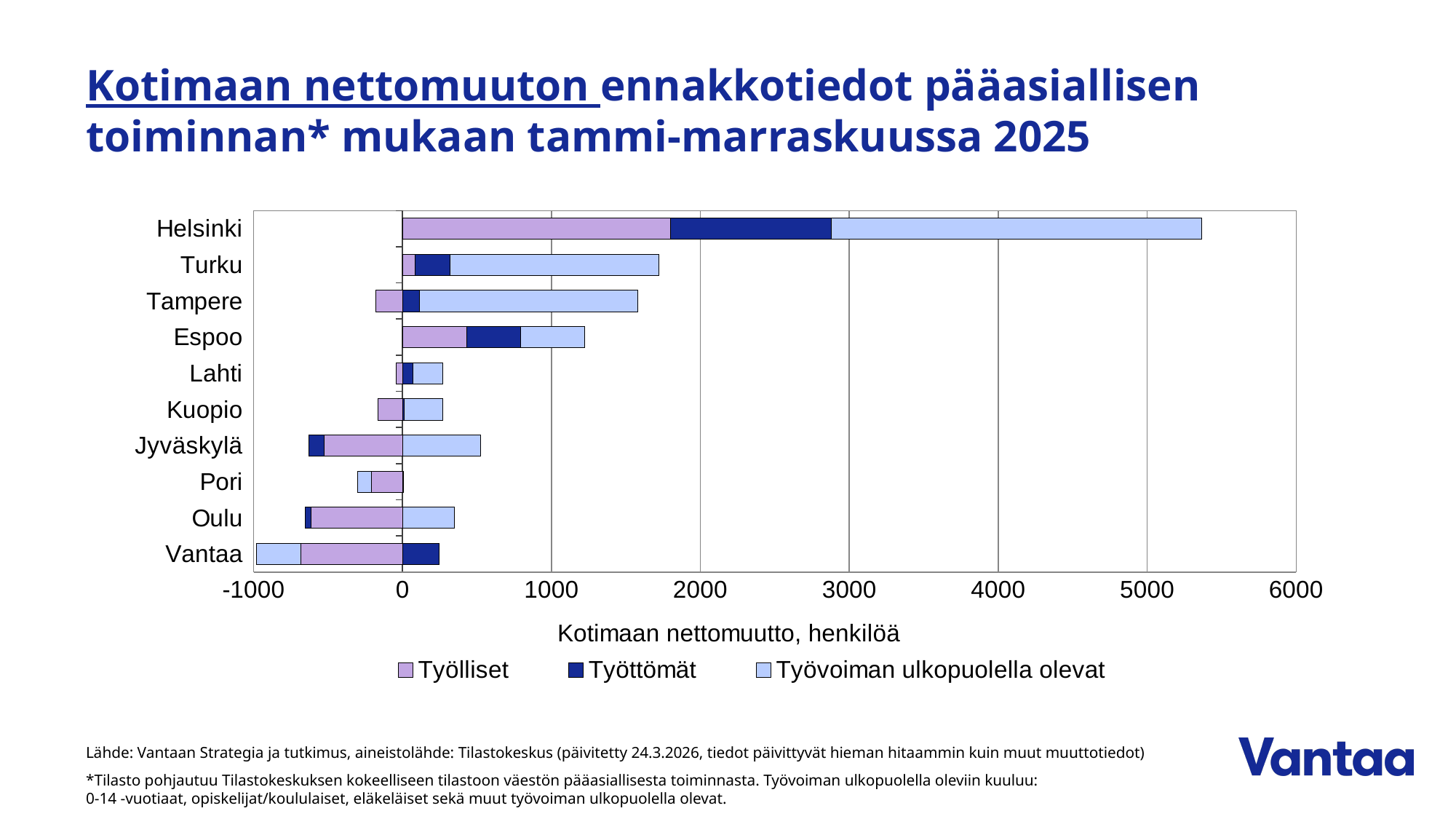
Is the Työlliset value for Vantaa greater or less than 0? less Which city has the largest Työlliset (employed) net migration value? Helsinki What is the label of the horizontal axis of the chart? Kotimaan nettomuutto, henkilöä What kind of chart is shown on the slide? Stacked bar chart Which legend entry is shown in the darkest blue colour? Työttömät Which is larger, the Työlliset value for Helsinki or the Työlliset value for Espoo? Helsinki Is the Työlliset value for Espoo greater or less than 1000? less Which city has the longest positive stacked bar overall? Helsinki Is the Työvoiman ulkopuolella olevat value for Turku greater or less than 1000? greater How many series does the chart legend list? 3 How many cities are listed on the vertical axis of the chart? 10